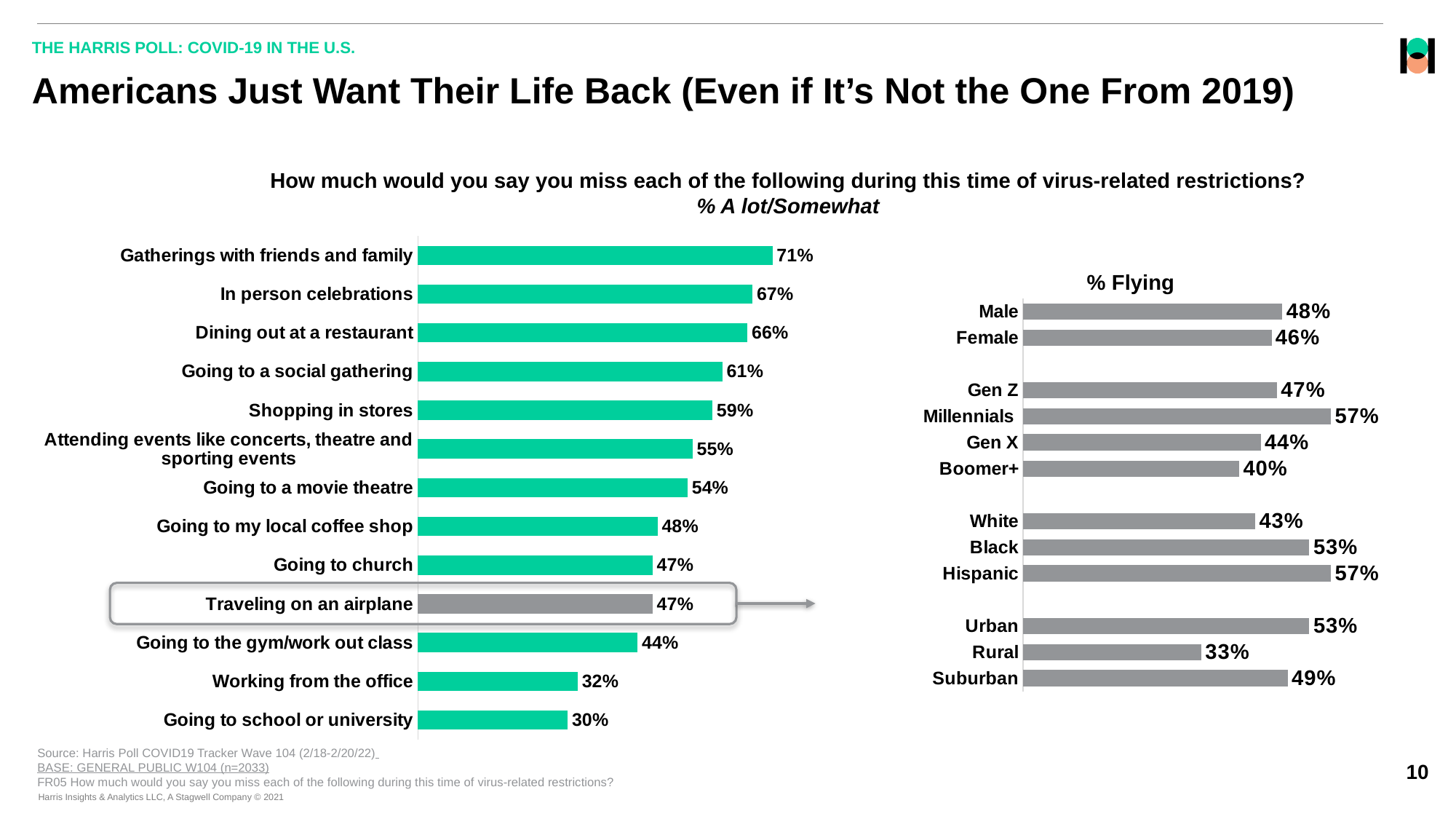
In the left chart on how much people miss each activity, what is the difference between Dining out at a restaurant and Working from the office? 34 percentage points In the left chart on how much people miss each activity, which category has the lowest value? Going to school or university In the % Flying chart, what is the value for Millennials? 57% In the left chart on how much people miss each activity, what is the value for Going to the gym/work out class? 44% In the left chart on how much people miss each activity, which category's bar is shown in grey and highlighted with a box? Traveling on an airplane In the % Flying chart, which is larger, Male or Female? Male In the % Flying chart, what is the value for Rural? 33% What kind of chart is the % Flying chart? Bar chart In the left chart on how much people miss each activity, what is the value for Gatherings with friends and family? 71% In the % Flying chart, what is the difference between Black and White? 10 percentage points In the left chart on how much people miss each activity, how many categories are shown? 13 In the % Flying chart, which category has the lowest value? Rural